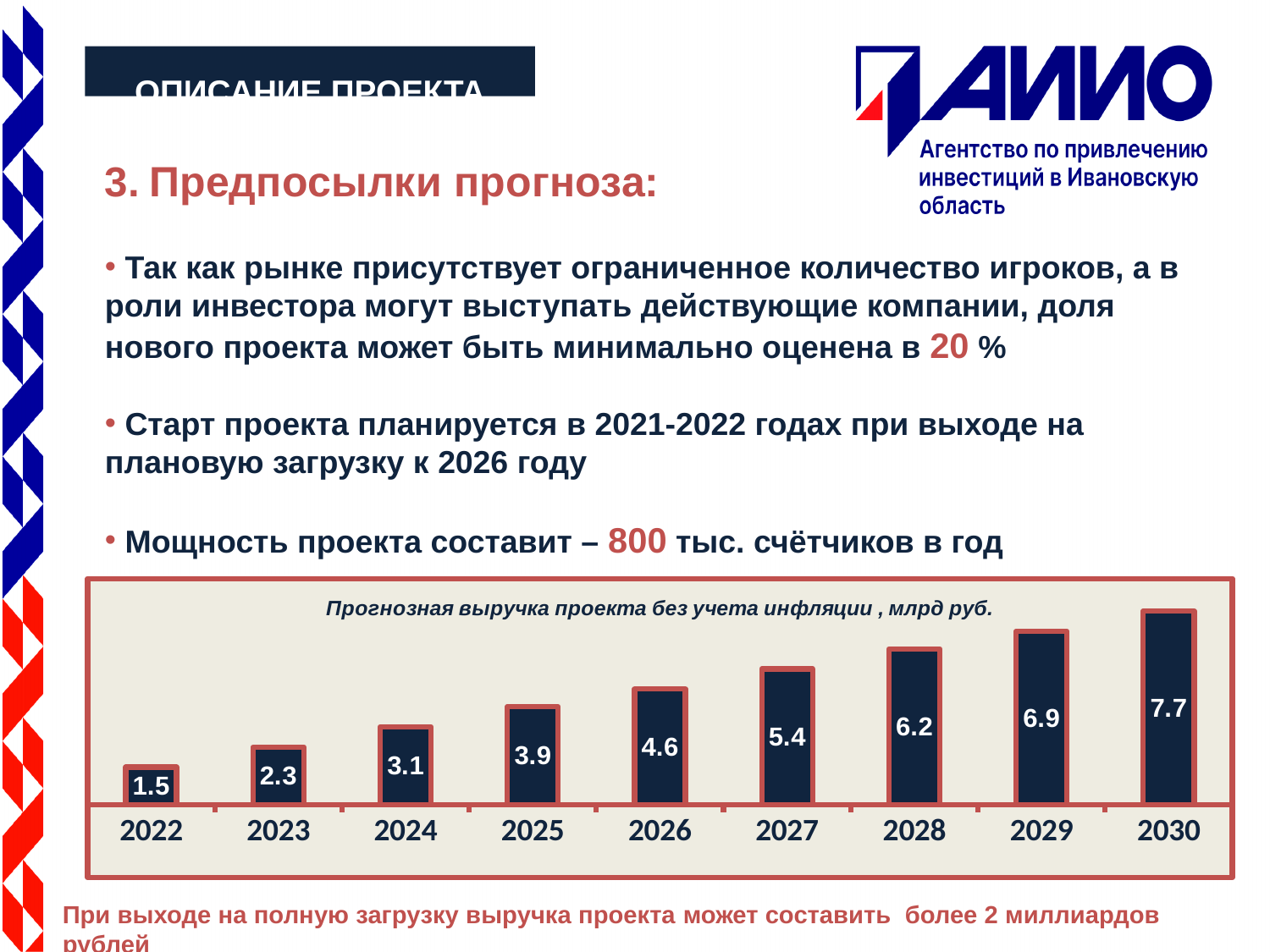
Which is larger, the forecast revenue for 2027 or for 2028? 2028 Which year has the highest forecast revenue? 2030 What is the difference between the forecast revenue for 2025 and 2024? 0.8 Which year has the lowest forecast revenue? 2022 What is the forecast revenue for 2022? 1.5 How many years are shown on the chart? 9 What is the title of the chart? Прогнозная выручка проекта без учета инфляции , млрд руб. What is the forecast revenue for 2029? 6.9 What is the forecast revenue for 2026? 4.6 Do the forecast revenue values rise or fall from 2022 to 2030? Rise What is the difference between the forecast revenue for 2030 and 2022? 6.2 What kind of chart is shown on the slide? Bar chart